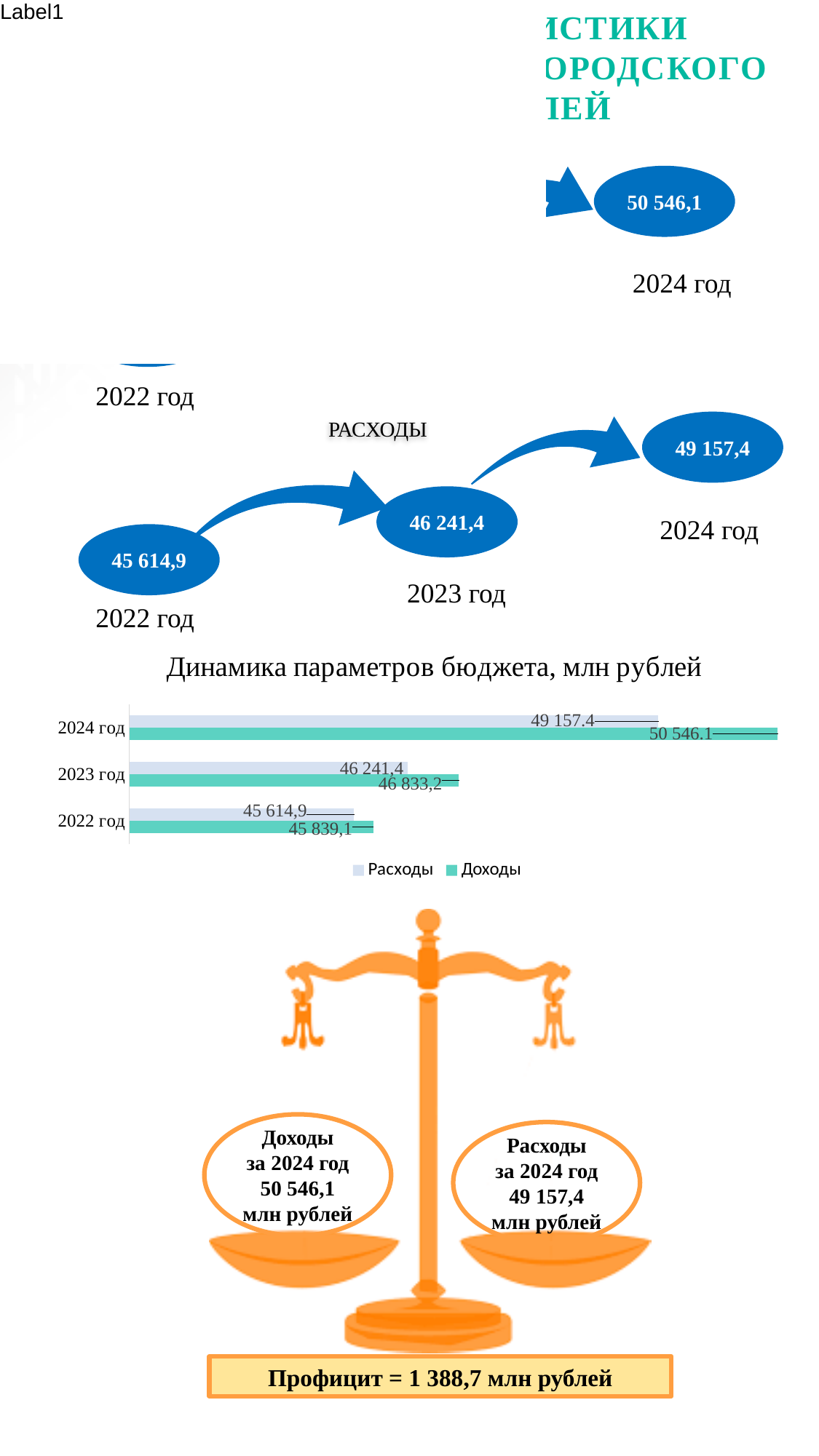
In the chart "Динамика параметров бюджета, млн рублей", what is the value of Расходы for 2023 год? 46 241,4 What type of chart is shown under the title "Динамика параметров бюджета, млн рублей"? bar chart In the chart "Динамика параметров бюджета, млн рублей", what is the value of Доходы for 2024 год? 50 546.1 In the chart "Динамика параметров бюджета, млн рублей", which year has the highest Доходы value? 2024 год In the chart "Динамика параметров бюджета, млн рублей", what is the difference between Доходы and Расходы for 2024 год? 1 388,7 How many years (categories) are shown in the chart "Динамика параметров бюджета, млн рублей"? 3 In the chart "Динамика параметров бюджета, млн рублей", what is the value of Расходы for 2024 год? 49 157.4 In the chart "Динамика параметров бюджета, млн рублей", what is the difference between Доходы and Расходы for 2023 год? 591,8 In the chart "Динамика параметров бюджета, млн рублей", which is larger for 2023 год: Доходы or Расходы? Доходы How many series does the legend of the chart "Динамика параметров бюджета, млн рублей" list? 2 In the chart "Динамика параметров бюджета, млн рублей", which year has the lowest Расходы value? 2022 год In the chart "Динамика параметров бюджета, млн рублей", what is the value of Доходы for 2022 год? 45 839,1